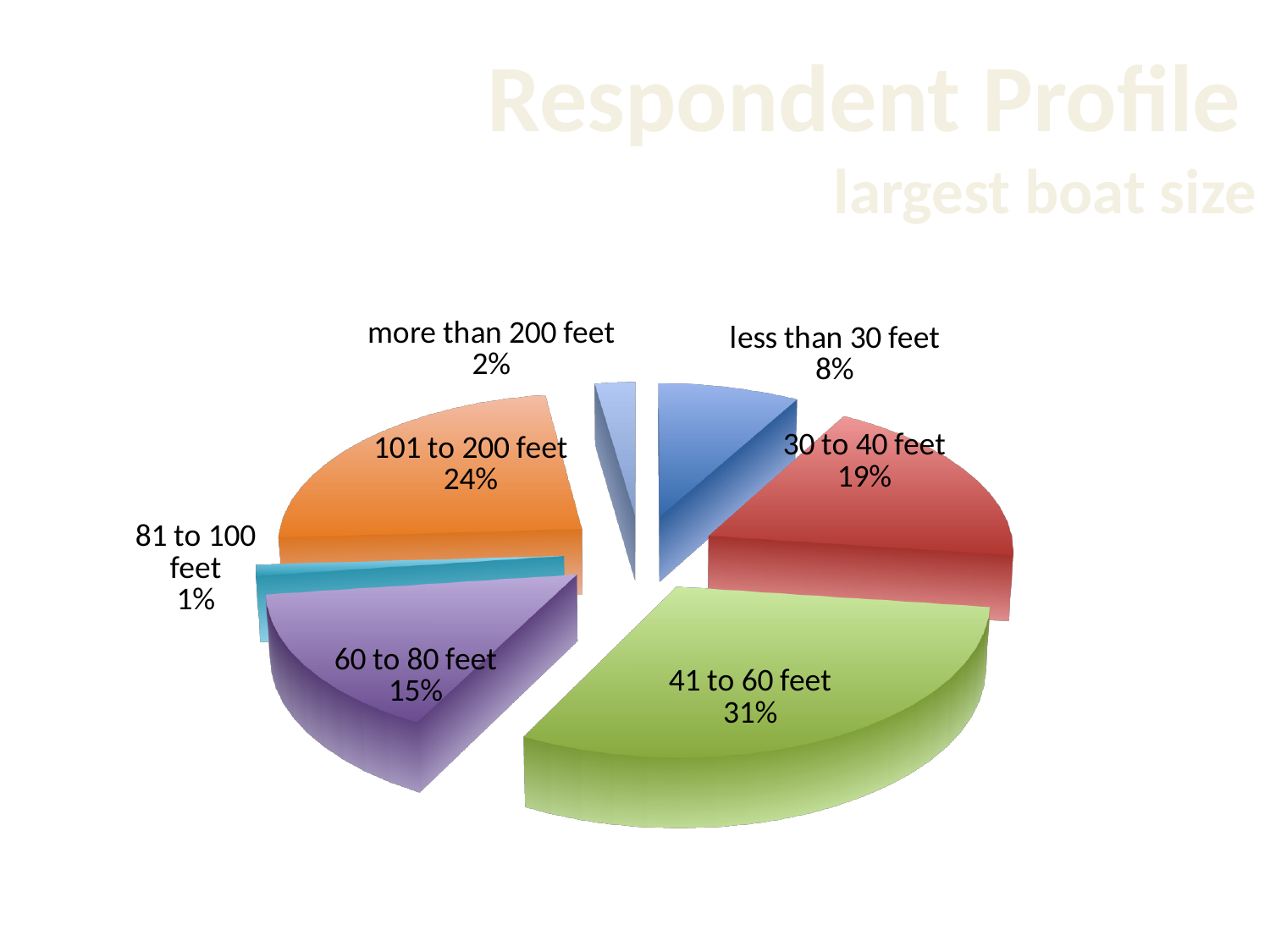
What is the difference in percentage points between the 41 to 60 feet slice and the 30 to 40 feet slice? 12 What percentage of respondents have a largest boat size of 41 to 60 feet? 31% What percentage is shown for the 101 to 200 feet slice? 24% How many slices does the pie chart have? 7 Which boat size category has the smallest share of the pie? 81 to 100 feet What percentage is shown for the less than 30 feet slice? 8% What percentage is shown for the 81 to 100 feet slice? 1% What is the combined share of the 101 to 200 feet and more than 200 feet slices? 26% Which boat size category has the largest share of the pie? 41 to 60 feet What is the subtitle of the chart shown on the slide? largest boat size What kind of chart is shown on the slide? pie chart Which slice is larger: 60 to 80 feet or 101 to 200 feet? 101 to 200 feet